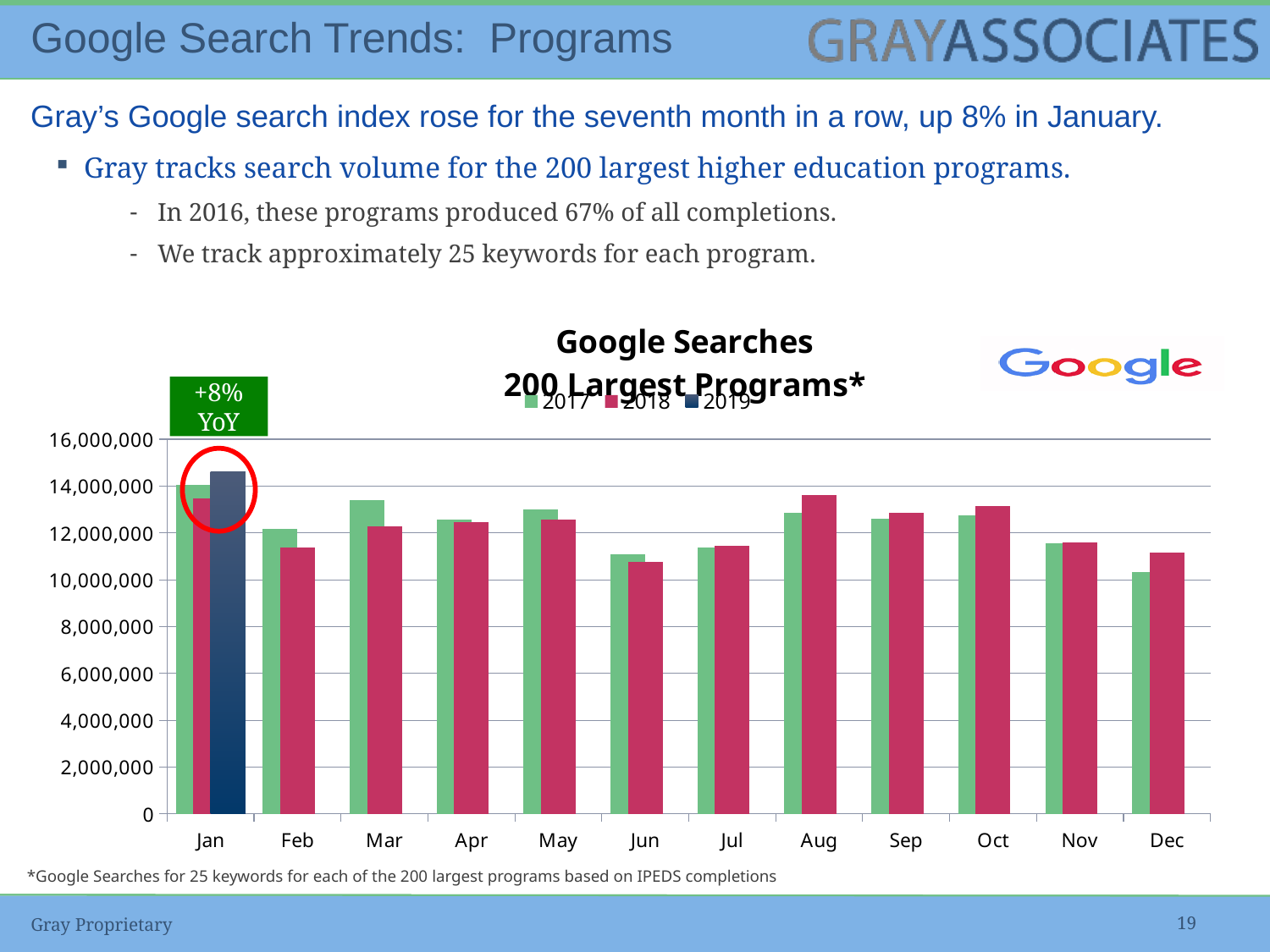
Is the 2019 value for Jan greater or less than 14,000,000? greater Is the 2017 value for Jun greater or less than 12,000,000? less What year-over-year change is annotated above the January bars? +8% YoY Which month has the lowest 2018 value in the Google Searches chart? Jun In February, which is larger: the 2017 value or the 2018 value? 2017 Which month has the lowest 2017 value in the Google Searches chart? Dec In December, which is larger: the 2017 value or the 2018 value? 2018 How many series does the legend of the Google Searches chart list? 3 How many months are shown along the x axis of the Google Searches chart? 12 In January, is the 2019 value larger or the 2018 value larger? 2019 Which month has the highest 2018 value in the Google Searches chart? Aug What kind of chart is shown on the slide? Bar chart